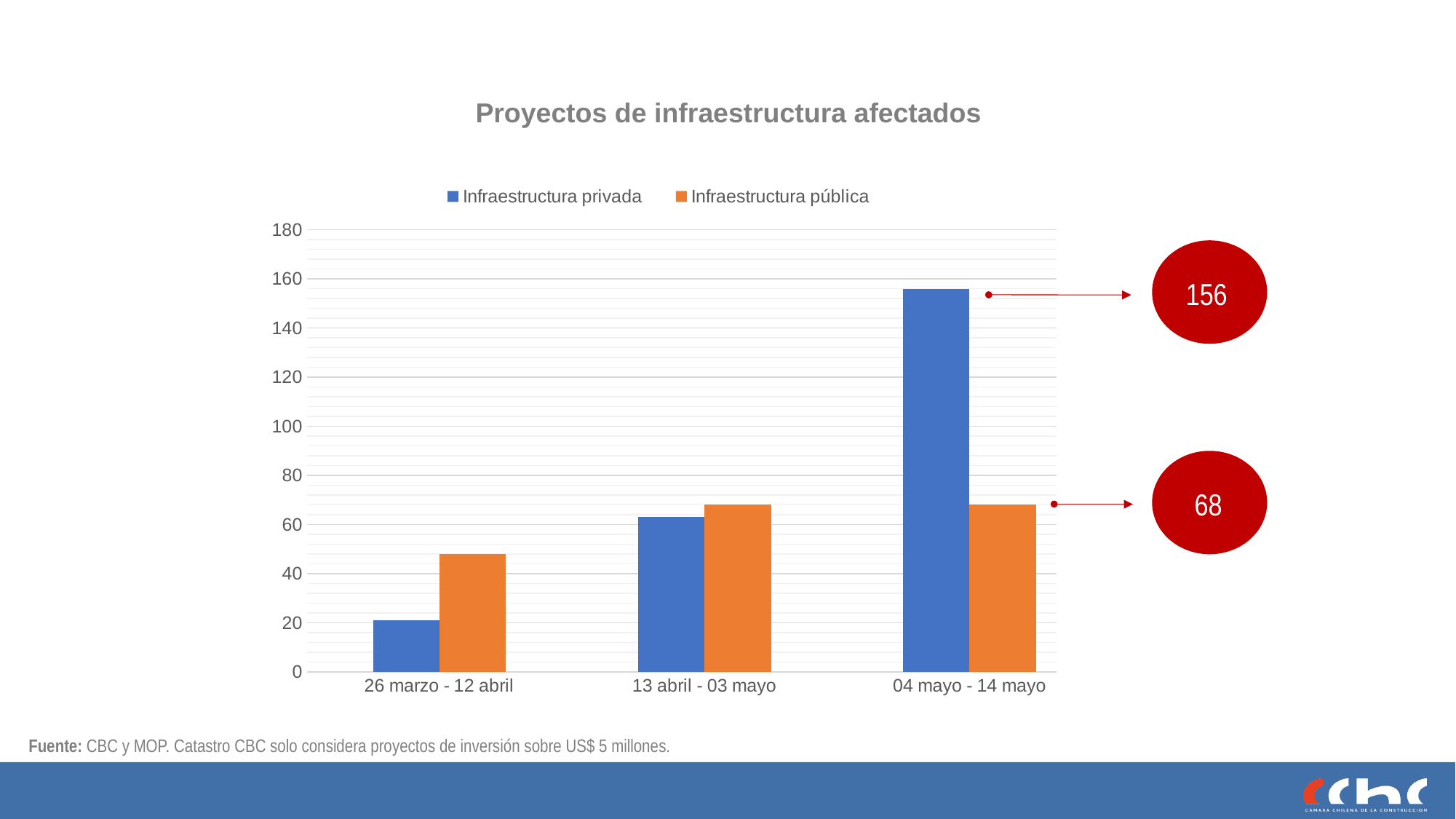
Which period has the lowest value for Infraestructura pública? 26 marzo - 12 abril What is the value for Infraestructura pública in the period 04 mayo - 14 mayo? 68 What type of chart is shown on the slide? bar chart Which period has the highest value for Infraestructura privada? 04 mayo - 14 mayo How many time periods are shown on the x axis? 3 In the period 26 marzo - 12 abril, which is larger: Infraestructura privada or Infraestructura pública? Infraestructura pública Do the values for Infraestructura privada rise or fall across the periods from left to right? rise Is the value for Infraestructura privada in the period 26 marzo - 12 abril greater or less than 40? less How many series does the legend list? 2 What is the difference between Infraestructura privada and Infraestructura pública in the period 04 mayo - 14 mayo? 88 What is the title of the chart? Proyectos de infraestructura afectados What is the value for Infraestructura privada in the period 04 mayo - 14 mayo? 156